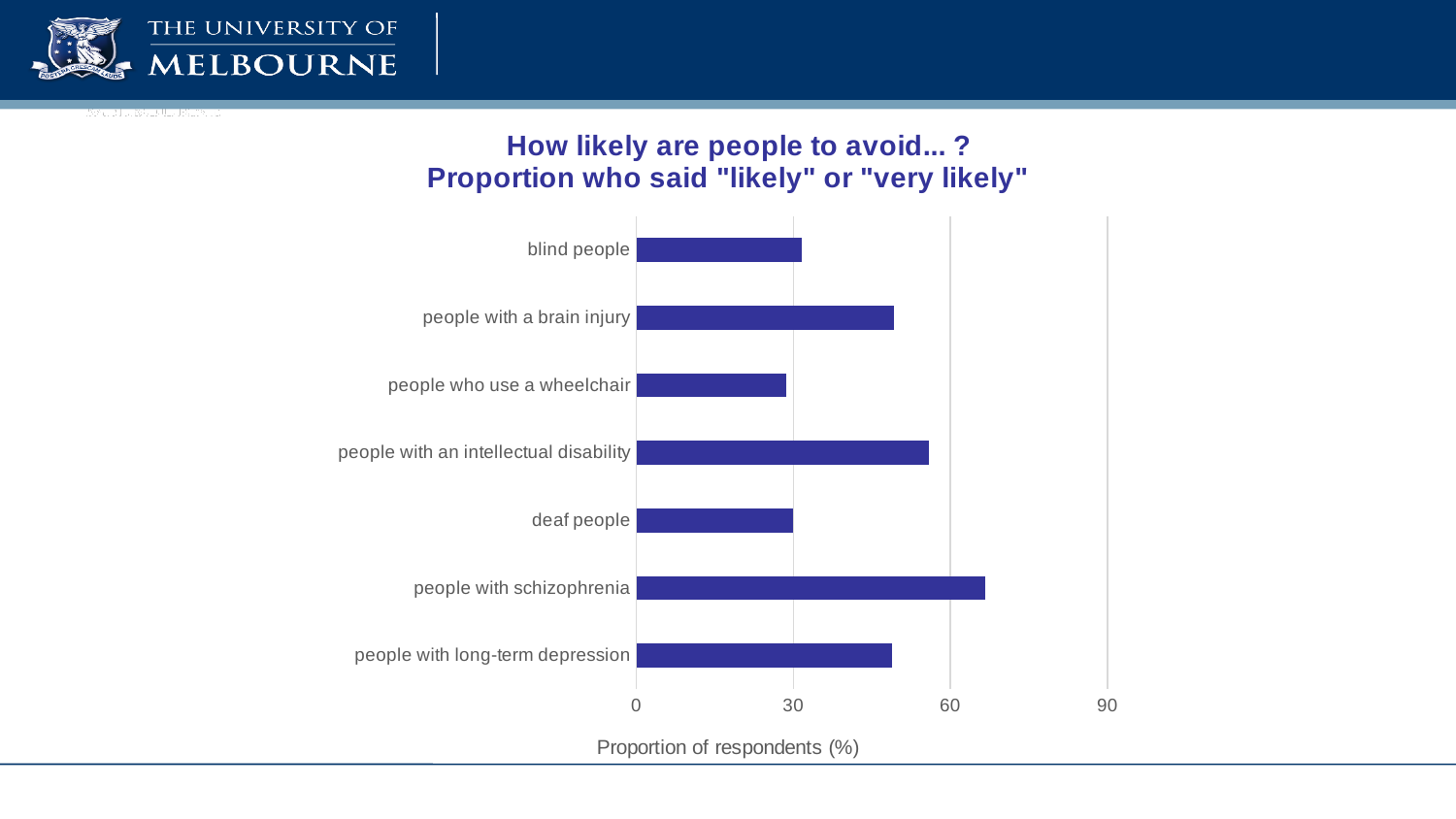
Is the value for people with a brain injury greater or less than 30? greater Is the value for people with long-term depression greater or less than 60? less Which is larger: the value for people with schizophrenia or the value for people with an intellectual disability? people with schizophrenia Which is larger: the value for blind people or the value for people with a brain injury? people with a brain injury Which category has the highest proportion of respondents who said they would be likely or very likely to avoid them? people with schizophrenia How many categories of people are shown in the chart? 7 Is the value for people with schizophrenia greater or less than 60? greater What kind of chart is shown on the slide? bar chart What is the label of the horizontal axis? Proportion of respondents (%) What is the highest tick value shown on the horizontal axis? 90